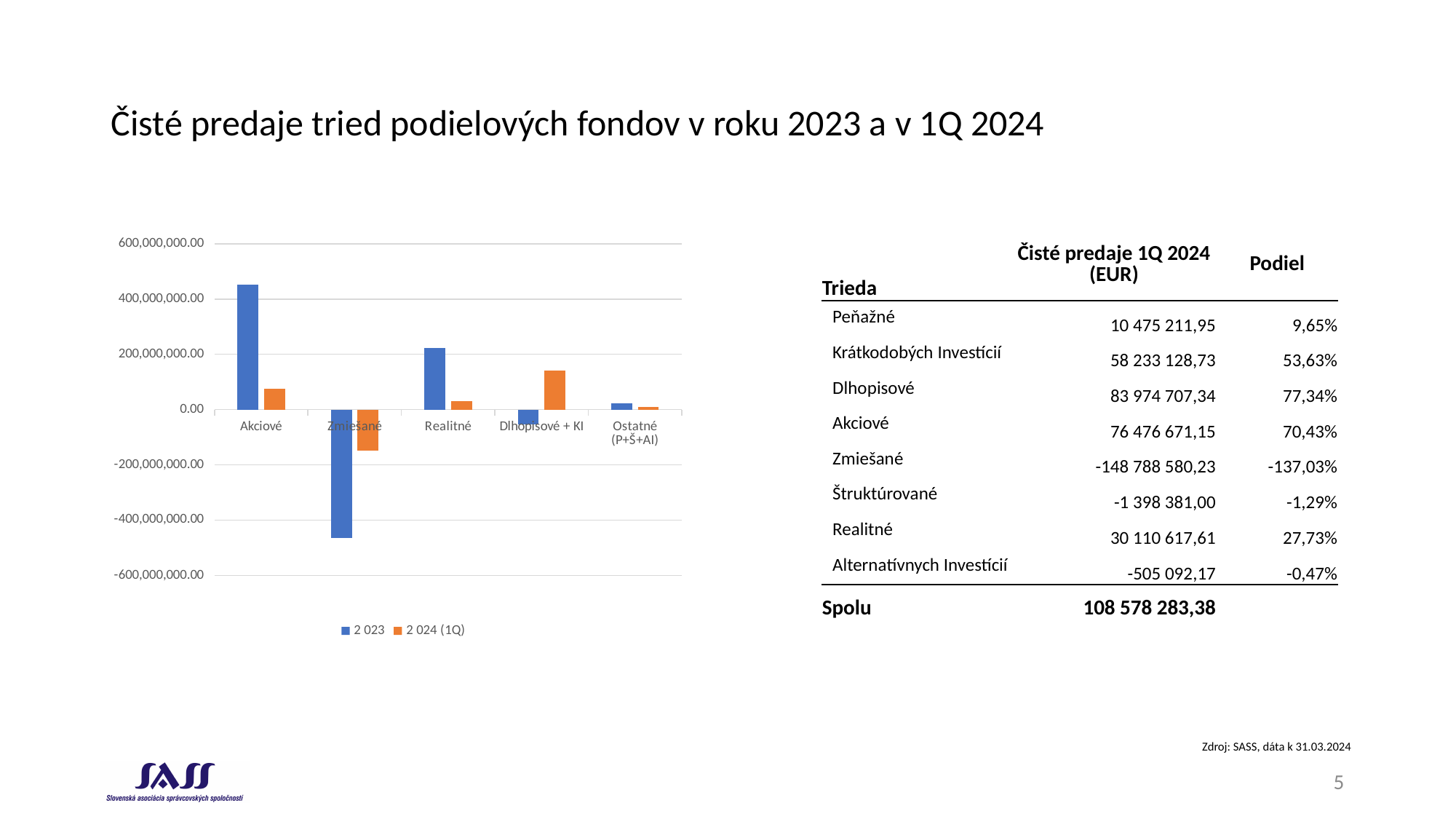
Is the 2 023 value for Akciové greater or less than 400,000,000.00? greater Is the 2 023 value for Zmiešané greater or less than -400,000,000.00? less Which category has the lowest value for the 2 023 series in the chart? Zmiešané What are the two series names listed in the chart's legend? 2 023 and 2 024 (1Q) Which category has the lowest value for the 2 024 (1Q) series in the chart? Zmiešané In the 2 023 series, which is larger: Akciové or Realitné? Akciové In the 2 024 (1Q) series, which is larger: Dlhopisové + KI or Akciové? Dlhopisové + KI How many categories are shown on the x axis of the chart? 5 Which category has the highest value for the 2 024 (1Q) series in the chart? Dlhopisové + KI What kind of chart is shown on the slide? bar chart Which category has the highest value for the 2 023 series in the chart? Akciové How many series does the chart's legend list? 2